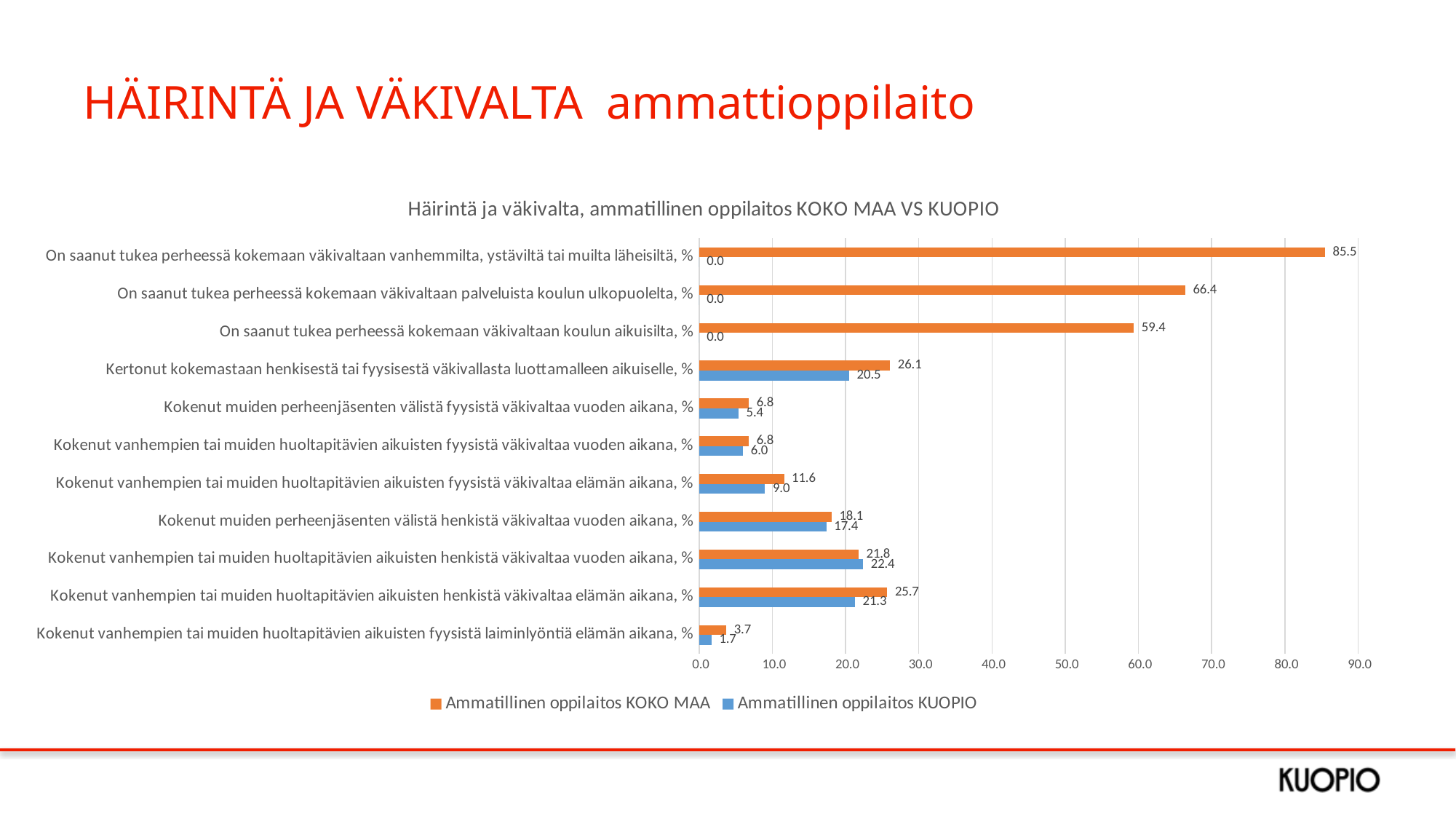
How many categories are shown on the chart? 11 Which category has the highest value for 'Ammatillinen oppilaitos KOKO MAA'? On saanut tukea perheessä kokemaan väkivaltaan vanhemmilta, ystäviltä tai muilta läheisiltä, % Which category has the highest value for 'Ammatillinen oppilaitos KUOPIO'? Kokenut vanhempien tai muiden huoltapitävien aikuisten henkistä väkivaltaa vuoden aikana, % What is the title of the chart? Häirintä ja väkivalta, ammatillinen oppilaitos KOKO MAA VS KUOPIO Is the KOKO MAA value for 'On saanut tukea perheessä kokemaan väkivaltaan palveluista koulun ulkopuolelta, %' greater or less than 60.0? greater How many series does the legend list? 2 What is the value for 'Ammatillinen oppilaitos KOKO MAA' in the category 'On saanut tukea perheessä kokemaan väkivaltaan vanhemmilta, ystäviltä tai muilta läheisiltä, %'? 85.5 What is the value for 'Ammatillinen oppilaitos KOKO MAA' in the category 'Kokenut vanhempien tai muiden huoltapitävien aikuisten fyysistä väkivaltaa elämän aikana, %'? 11.6 What is the difference between the KOKO MAA and KUOPIO values for 'Kokenut vanhempien tai muiden huoltapitävien aikuisten henkistä väkivaltaa elämän aikana, %'? 4.4 For 'Kokenut vanhempien tai muiden huoltapitävien aikuisten henkistä väkivaltaa vuoden aikana, %', which series has the larger value, KOKO MAA or KUOPIO? Ammatillinen oppilaitos KUOPIO What is the value for 'Ammatillinen oppilaitos KUOPIO' in the category 'Kertonut kokemastaan henkisestä tai fyysisestä väkivallasta luottamalleen aikuiselle, %'? 20.5 What kind of chart is shown on the slide? Bar chart